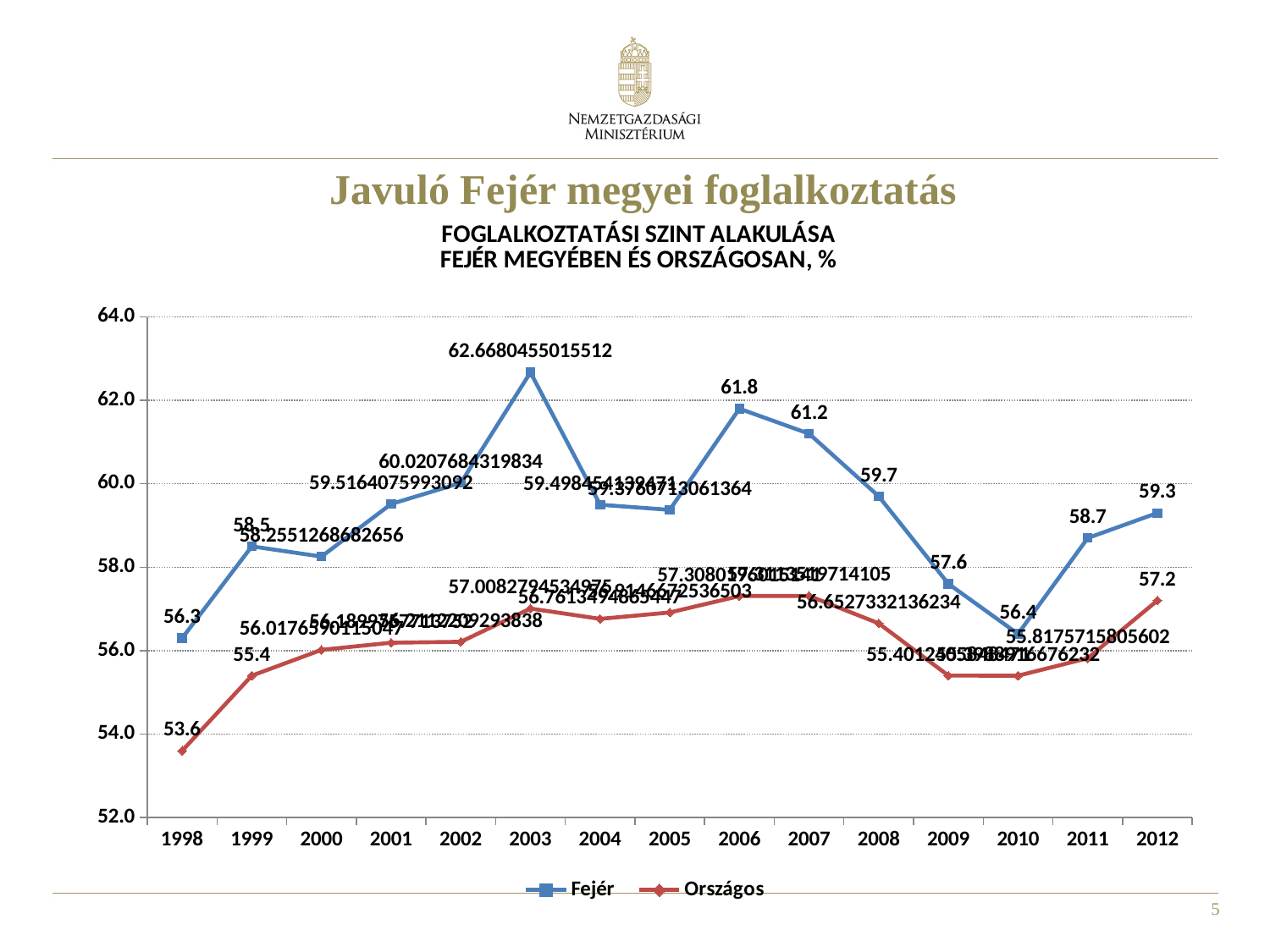
What is the Országos value for 1998? 53.6 Which is larger, the Fejér value for 2006 or the Fejér value for 2007? 2006 What is the difference between the Fejér and Országos values in 2012? 2.1 How many years are shown on the x axis? 15 What is the Fejér value for 1998? 56.3 What is the Fejér value for 2012? 59.3 In which year does the Fejér series reach its highest value? 2003 In which year does the Országos series have its lowest value? 1998 Is the Országos value for 2009 greater or less than 56.0? less How many series does the legend list? 2 What kind of chart is shown on the slide? line chart What is the Országos value for 2012? 57.2